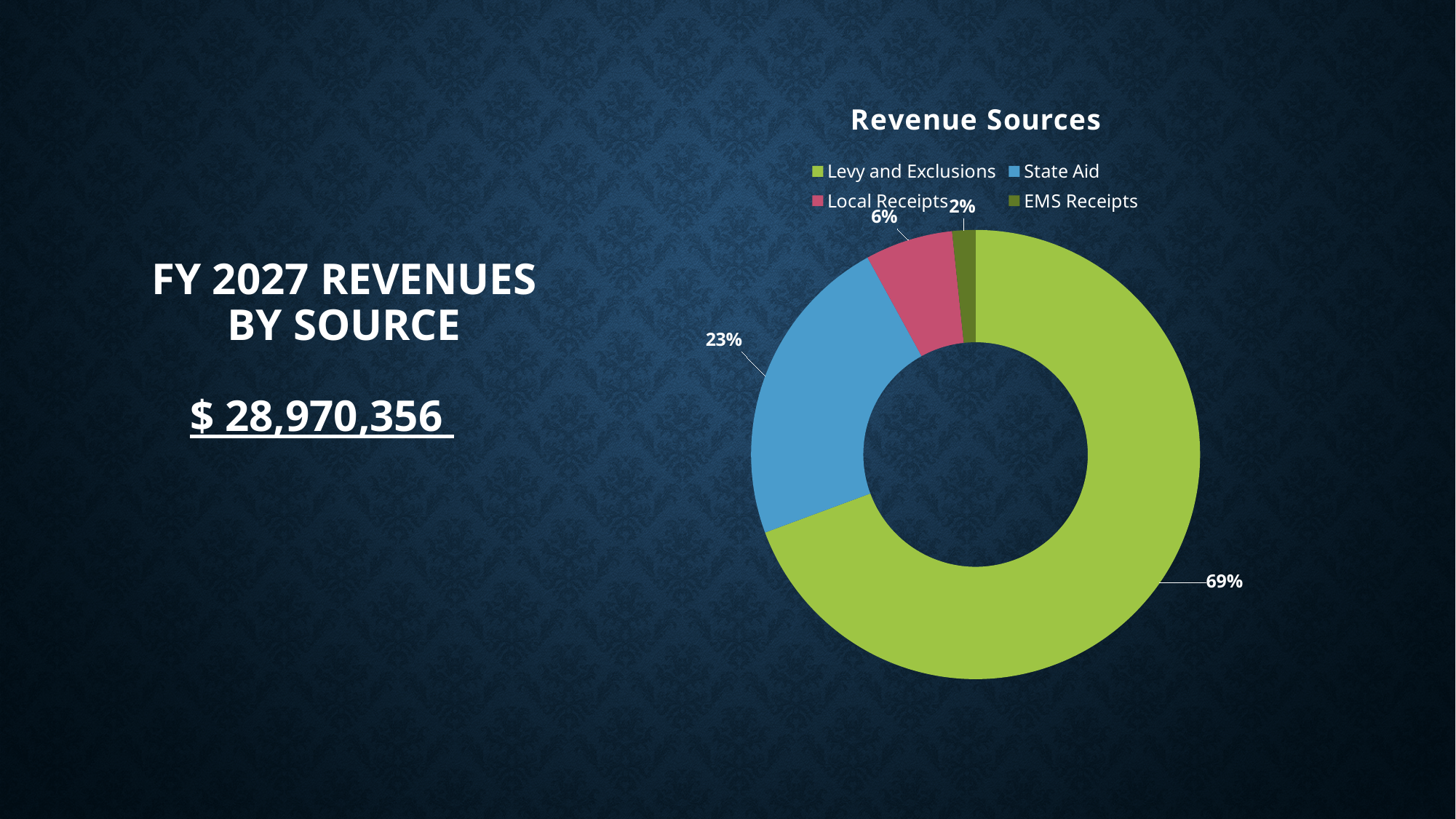
What share of revenue comes from Local Receipts? 6% What share of revenue comes from EMS Receipts? 2% What is the title of the chart? Revenue Sources What share of revenue comes from State Aid? 23% Which revenue source has the largest share? Levy and Exclusions How many revenue sources are shown in the chart? 4 What colour represents State Aid in the chart? Blue What kind of chart is shown on the slide? Pie chart (doughnut) What is the difference in percentage points between Levy and Exclusions and State Aid? 46 Which revenue source has the smallest share? EMS Receipts Which is larger, the share for Local Receipts or the share for EMS Receipts? Local Receipts